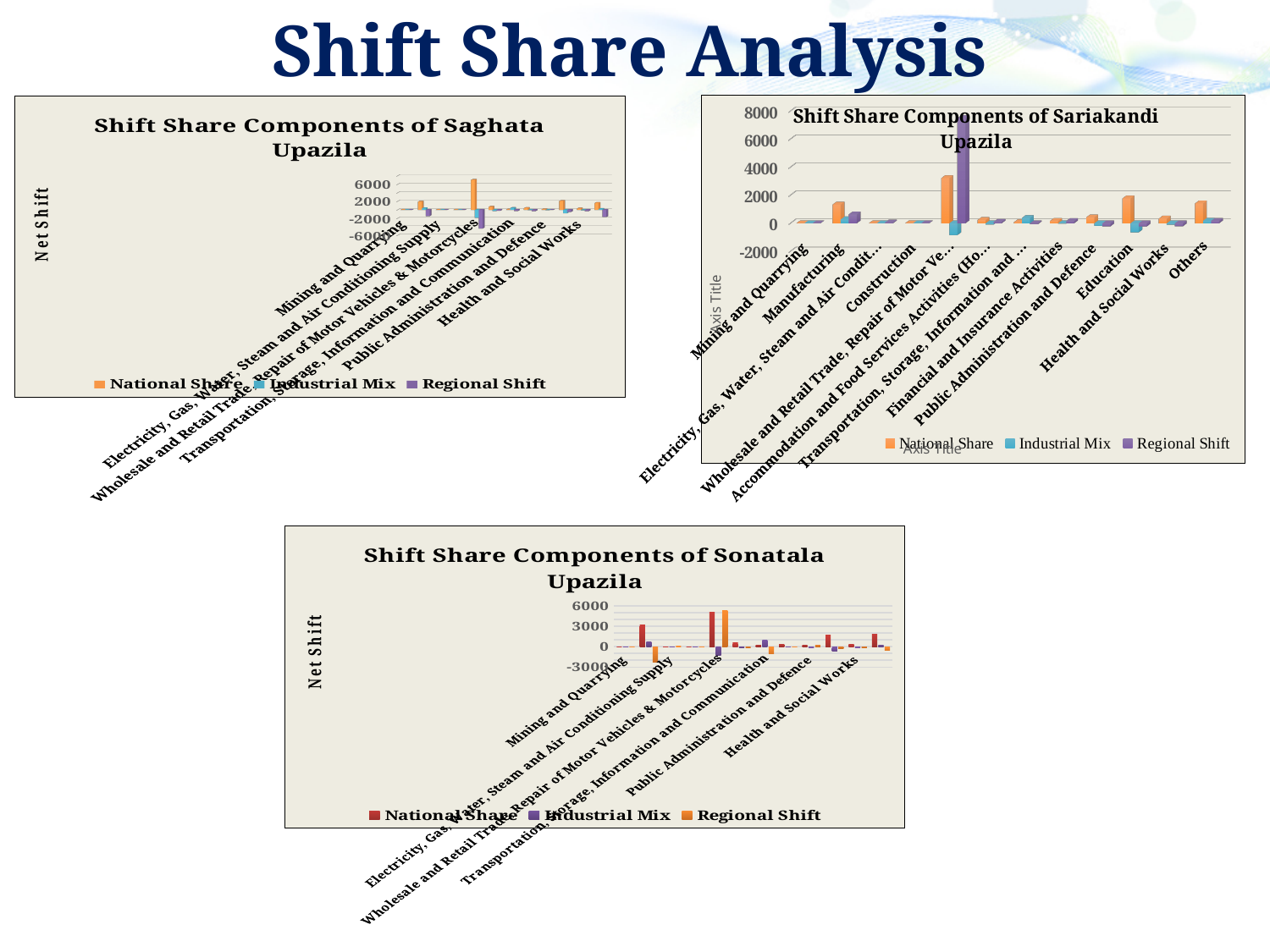
In the 'Shift Share Components of Sariakandi Upazila' chart, which is larger: the National Share for Manufacturing or the National Share for Wholesale and Retail Trade? Wholesale and Retail Trade What is the y-axis title of the 'Shift Share Components of Sonatala Upazila' chart? Net Shift In the 'Shift Share Components of Sariakandi Upazila' chart, is the Regional Shift value for Wholesale and Retail Trade greater or less than 6000? greater What colour represents National Share in the 'Shift Share Components of Sonatala Upazila' chart? dark red In the 'Shift Share Components of Saghata Upazila' chart, is the National Share value for Wholesale and Retail Trade greater or less than 2000? greater How many series does the legend of the 'Shift Share Components of Saghata Upazila' chart list? 3 What kind of chart is the 'Shift Share Components of Sariakandi Upazila' chart? bar chart In the 'Shift Share Components of Sariakandi Upazila' chart, which series has the tallest bar? Regional Shift How many categories are shown on the x axis of the 'Shift Share Components of Sariakandi Upazila' chart? 12 In the 'Shift Share Components of Sonatala Upazila' chart, is the Regional Shift value for Wholesale and Retail Trade greater or less than 3000? greater